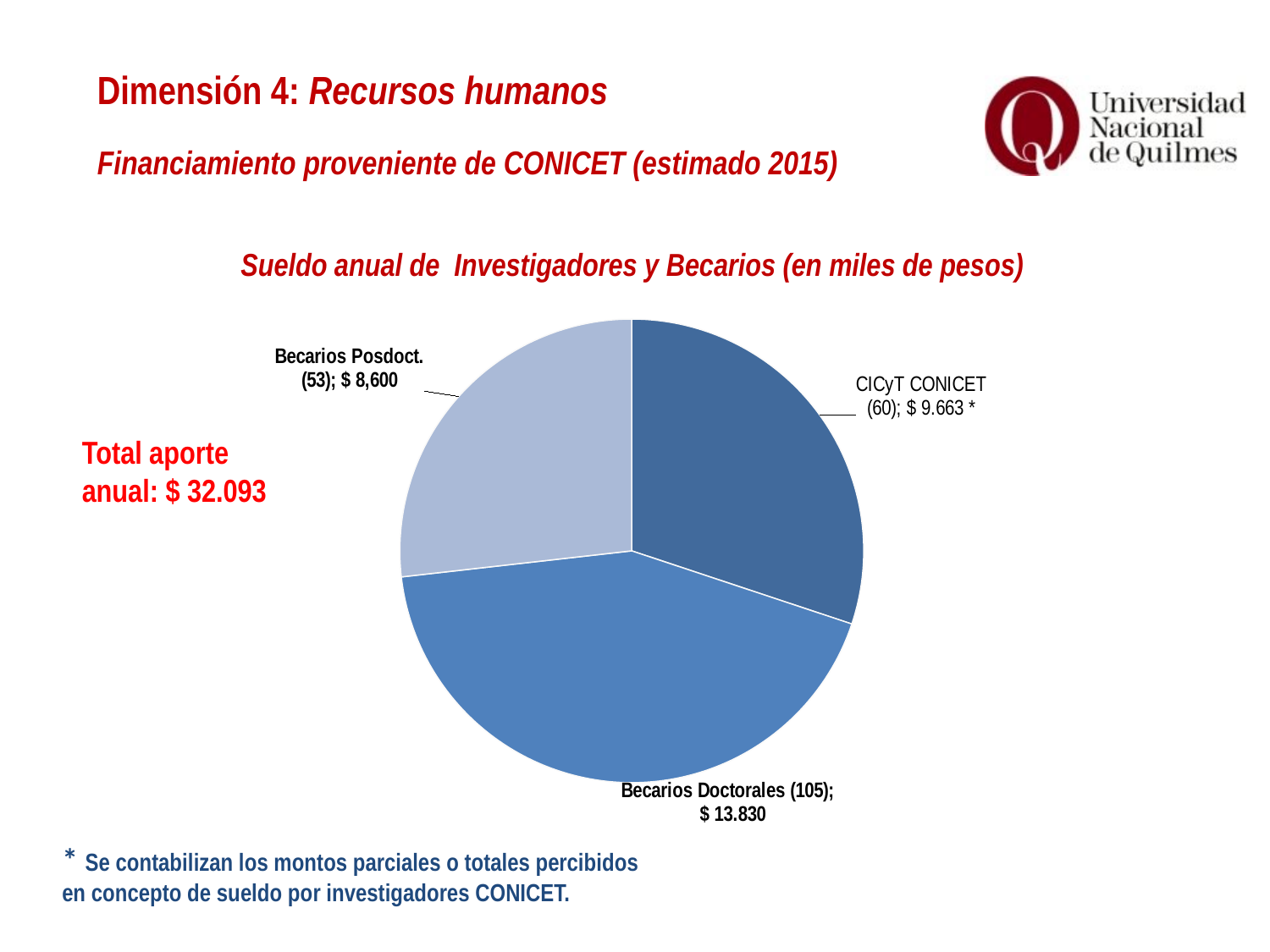
What is the annual salary value shown for Becarios Doctorales? $ 13.830 What is the difference between the value for Becarios Doctorales and the value for CICyT CONICET? $ 4.167 What is the total annual contribution (Total aporte anual) shown on the slide? $ 32.093 What is the annual salary value shown for Becarios Posdoct.? $ 8,600 What kind of chart is shown on the slide? pie chart How many slices does the pie chart have? 3 Which category has the smallest slice of the pie? Becarios Posdoct. What is the title of the pie chart? Sueldo anual de Investigadores y Becarios (en miles de pesos) Which category has the largest slice of the pie? Becarios Doctorales Which is larger, the value for CICyT CONICET or the value for Becarios Posdoct.? CICyT CONICET How many Becarios Doctorales are indicated in the chart label? 105 What is the annual salary value shown for CICyT CONICET? $ 9.663